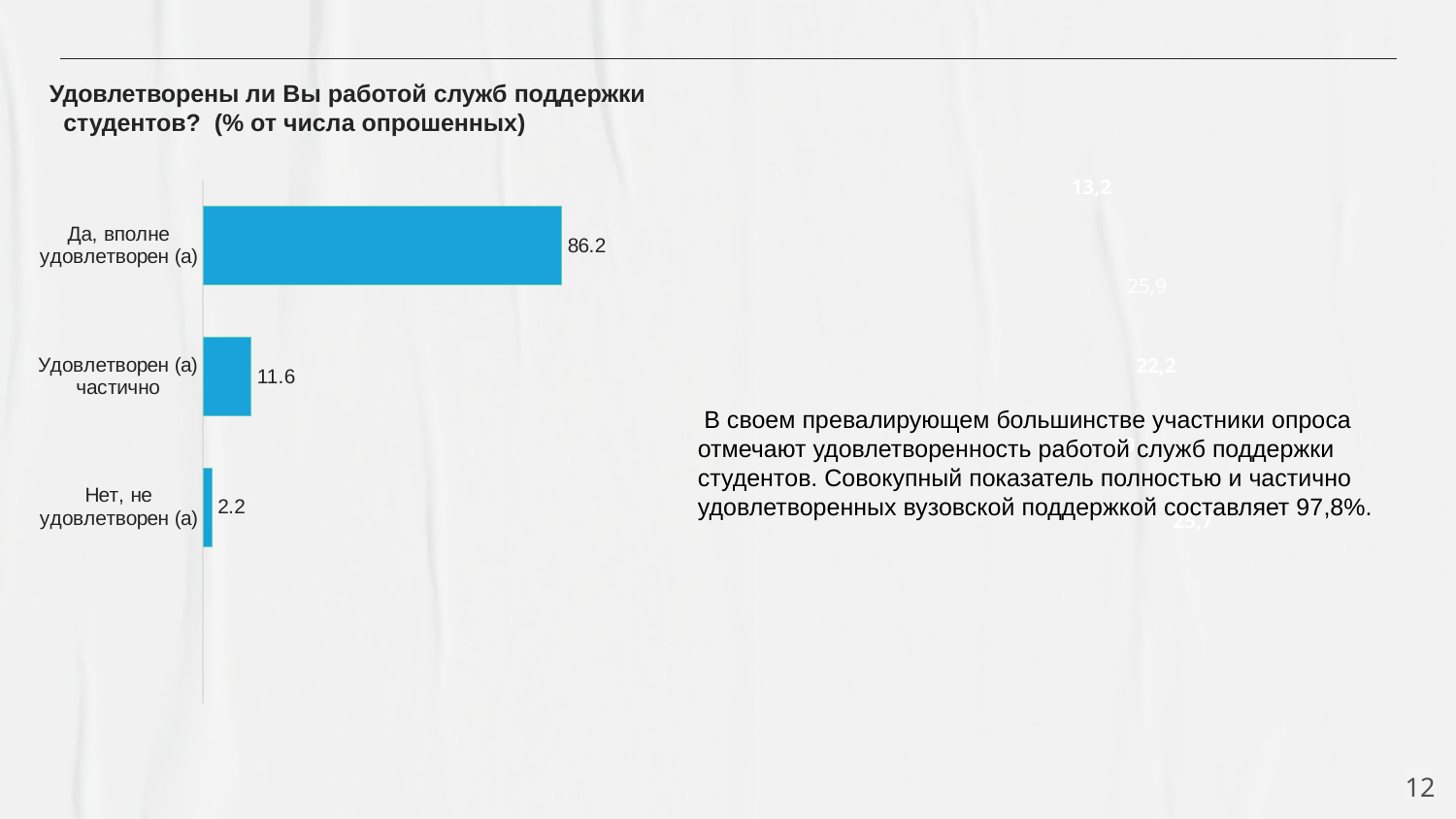
What is the difference between the values for "Да, вполне удовлетворен (а)" and "Удовлетворен (а) частично"? 74.6 What value is shown for "Удовлетворен (а) частично"? 11.6 What value is shown for "Нет, не удовлетворен (а)"? 2.2 Which category has the highest value? Да, вполне удовлетворен (а) What value is shown for "Да, вполне удовлетворен (а)"? 86.2 What is the difference between the values for "Удовлетворен (а) частично" and "Нет, не удовлетворен (а)"? 9.4 What is the title of the chart? Удовлетворены ли Вы работой служб поддержки студентов? (% от числа опрошенных) How many categories are shown in the chart? 3 What kind of chart is shown on the slide? Bar chart What colour are the bars in the chart? Blue Which category has the lowest value? Нет, не удовлетворен (а) Which is larger: the value for "Удовлетворен (а) частично" or for "Нет, не удовлетворен (а)"? Удовлетворен (а) частично